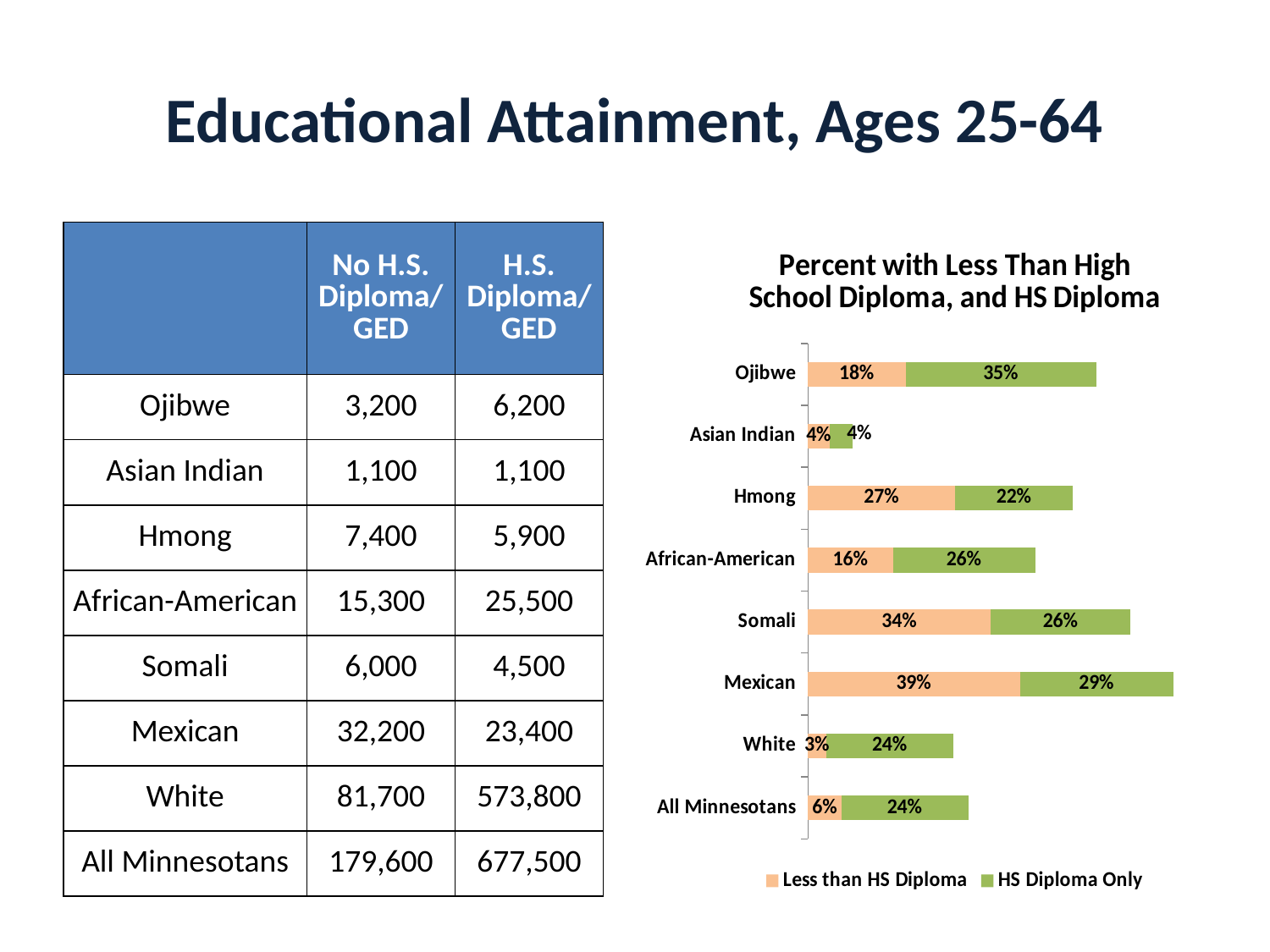
What is the combined total of the two segments for the Mexican bar? 68% Which group has the highest HS Diploma Only percentage in the chart? Ojibwe What is the difference between the Less than HS Diploma values for Hmong and African-American? 11% What type of chart is shown on the slide? Stacked bar chart Which group has the lowest Less than HS Diploma percentage in the chart? White Is the Less than HS Diploma value larger for Somali or for Ojibwe? Somali In the chart, what is the HS Diploma Only value for Ojibwe? 35% How many groups are shown on the chart's vertical axis? 8 In the chart, what is the Less than HS Diploma value for Somali? 34% In the chart, what is the Less than HS Diploma value for All Minnesotans? 6% How many series does the chart's legend list? 2 Which group has the highest Less than HS Diploma percentage in the chart? Mexican